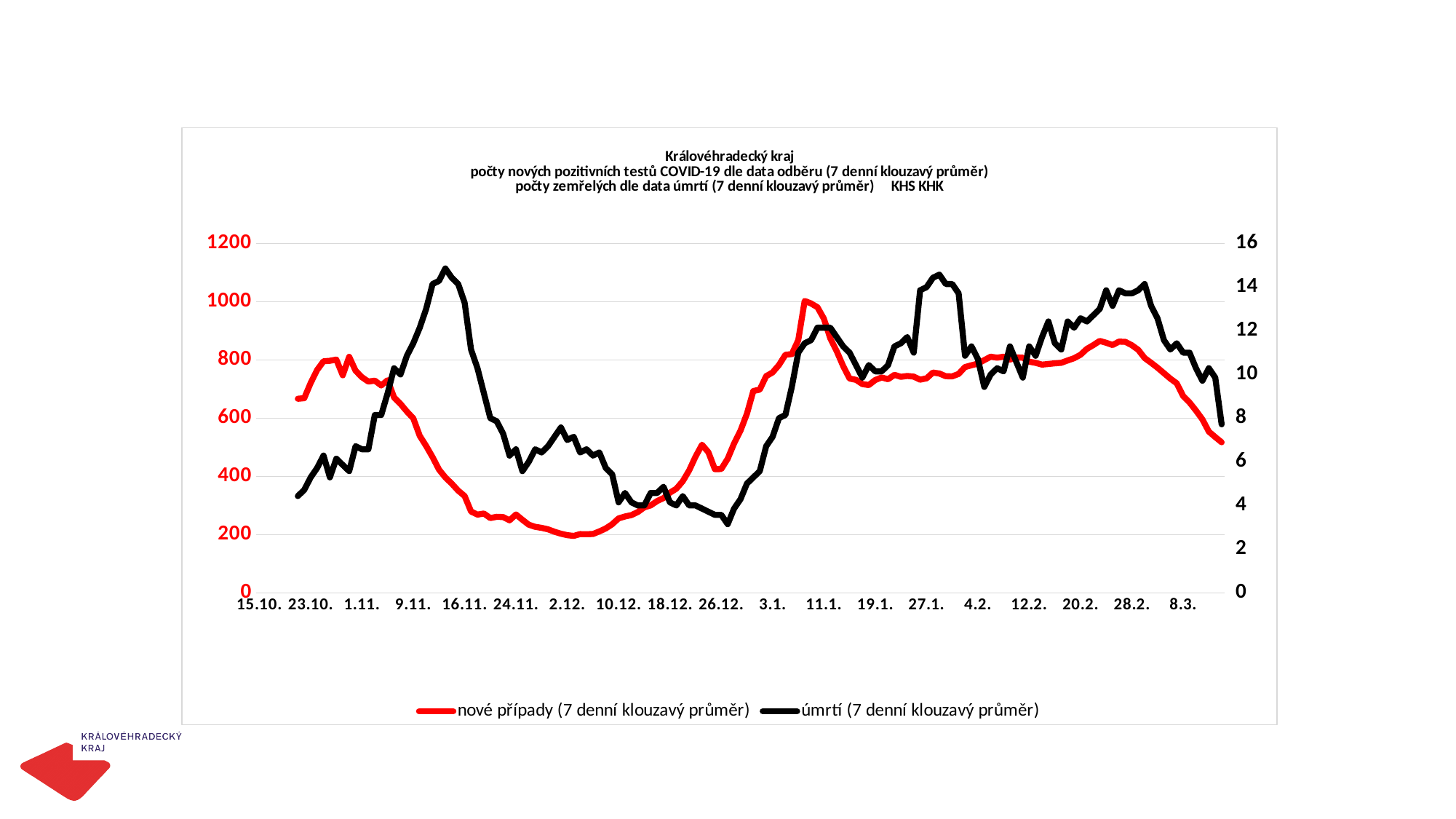
Which series is drawn in red according to the legend? nové případy (7 denní klouzavý průměr) Is the value of the red line (nové případy) at 10.12. greater or less than 400? less What kind of chart is shown on the slide? line chart Is the value of the black line (úmrtí) at 16.11. greater or less than 12? greater What is the highest value shown on the left vertical axis? 1200 Which is larger for the red line (nové případy): the value at 2.12. or the value at 11.1.? 11.1. Is the value of the red line (nové případy) at 2.12. greater or less than 400? less How many series does the legend list? 2 How many date labels are shown on the x axis? 19 Does the red line (nové případy) rise or fall between 1.11. and 2.12.? fall Does the red line (nové případy) rise or fall between 2.12. and 11.1.? rise